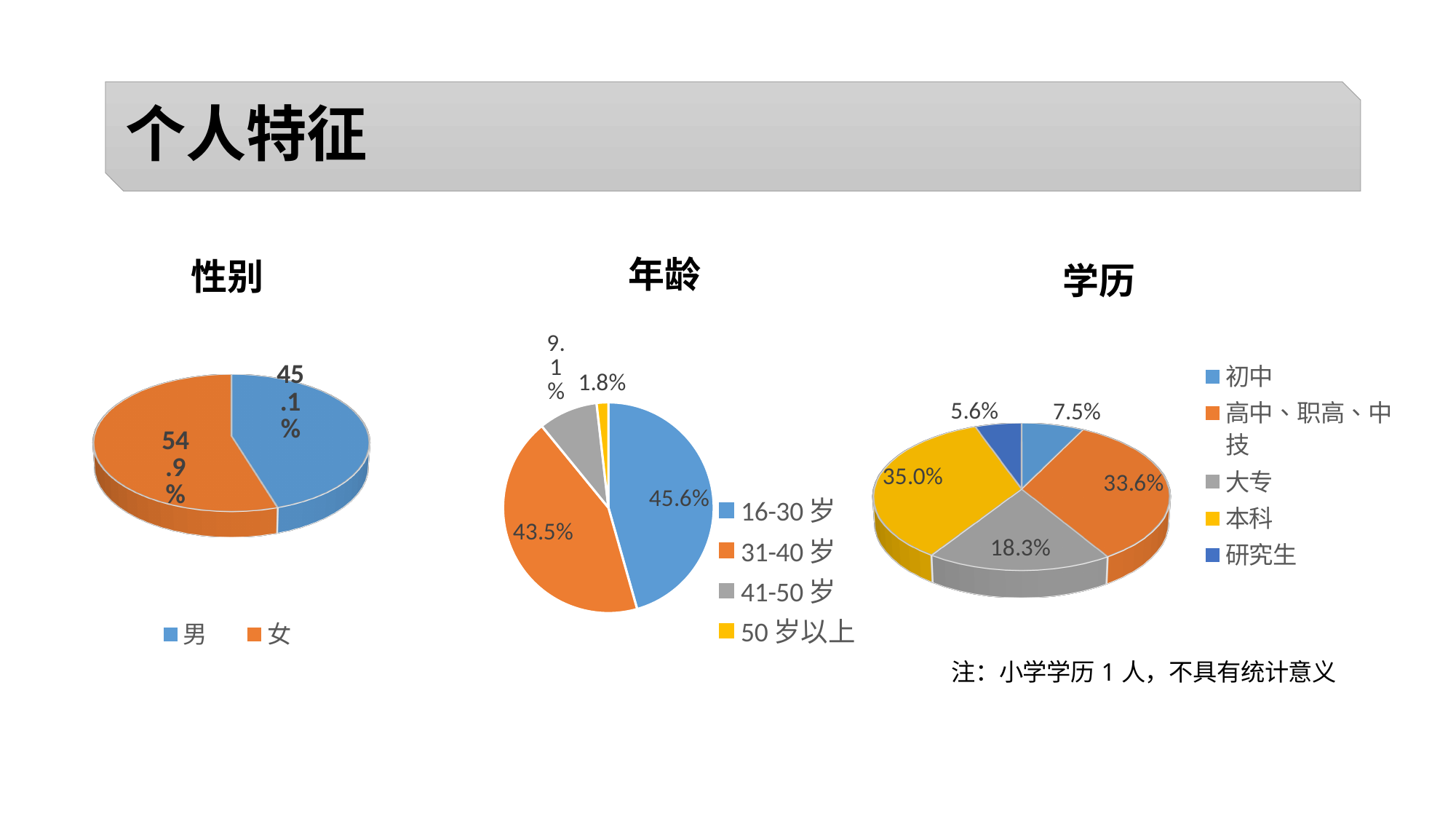
In the 年龄 chart, what percentage is shown for 31-40 岁? 43.5% In the 学历 chart, what percentage is shown for 大专? 18.3% What kind of chart is the 学历 chart? Pie chart In the 年龄 chart, which age group has the smallest share? 50 岁以上 In the 年龄 chart, what is the difference between the shares of 16-30 岁 and 31-40 岁? 2.1% In the 学历 chart, which education level has the largest share? 本科 In the 性别 chart, which category has the larger share, 男 or 女? 女 In the 年龄 chart, which age group has the largest share? 16-30 岁 How many categories does the legend of the 年龄 chart list? 4 In the 性别 chart, what percentage is shown for 男? 45.1% In the 性别 chart, what percentage is shown for 女? 54.9% In the 学历 chart, what is the difference between the shares of 高中、职高、中技 and 研究生? 28.0%